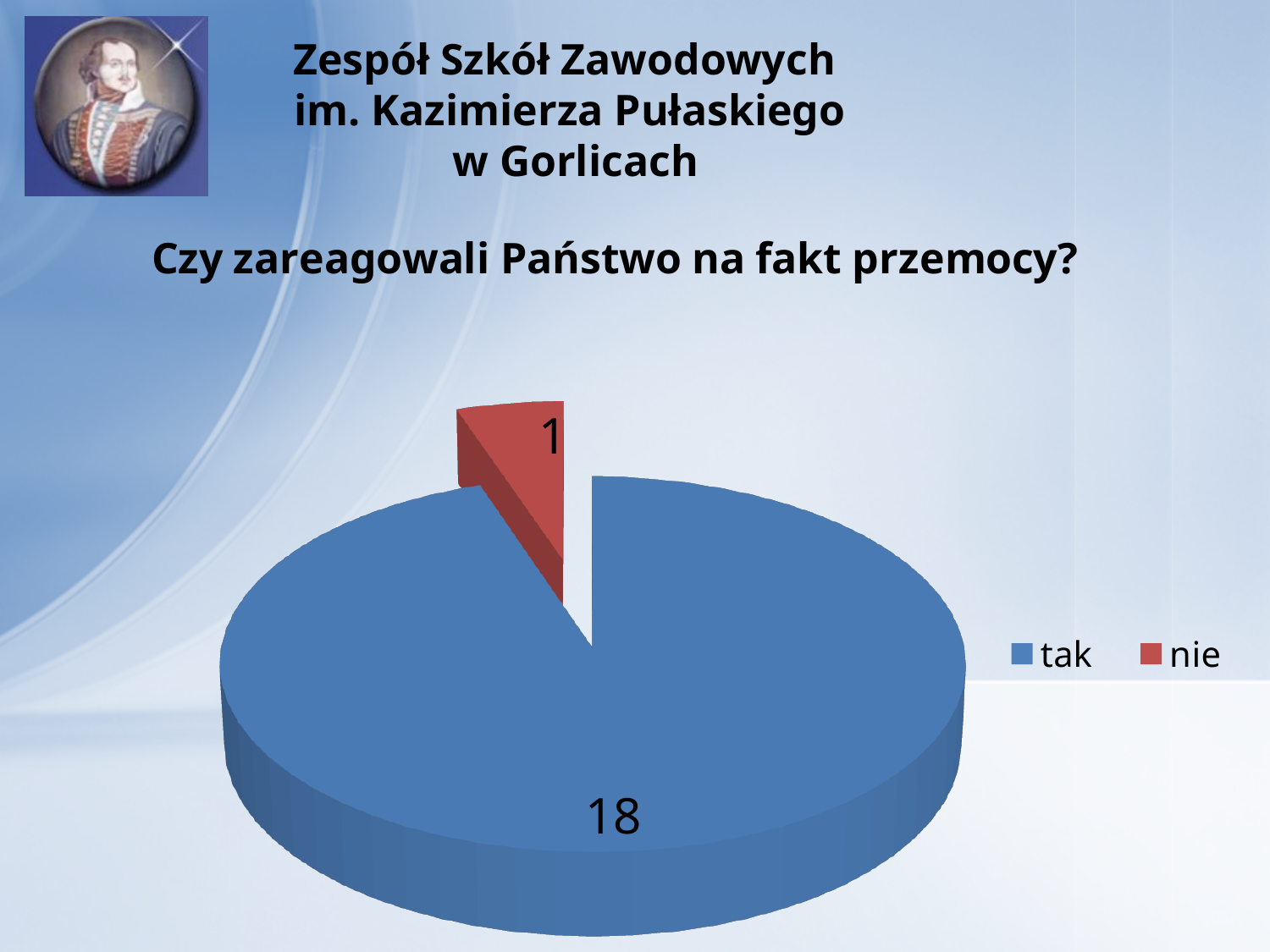
What is the difference between the values for "tak" and "nie"? 17 What question does the chart answer, according to the slide heading? Czy zareagowali Państwo na fakt przemocy? How many categories does the pie chart show? 2 What is the total of all slices in the pie chart? 19 Which category has the largest slice? tak What colour is the slice for "nie"? red What is the value for "tak"? 18 What is the value for "nie"? 1 Which category has the smallest slice? nie Which is larger, the value for "tak" or the value for "nie"? tak What kind of chart is shown on the slide? pie chart